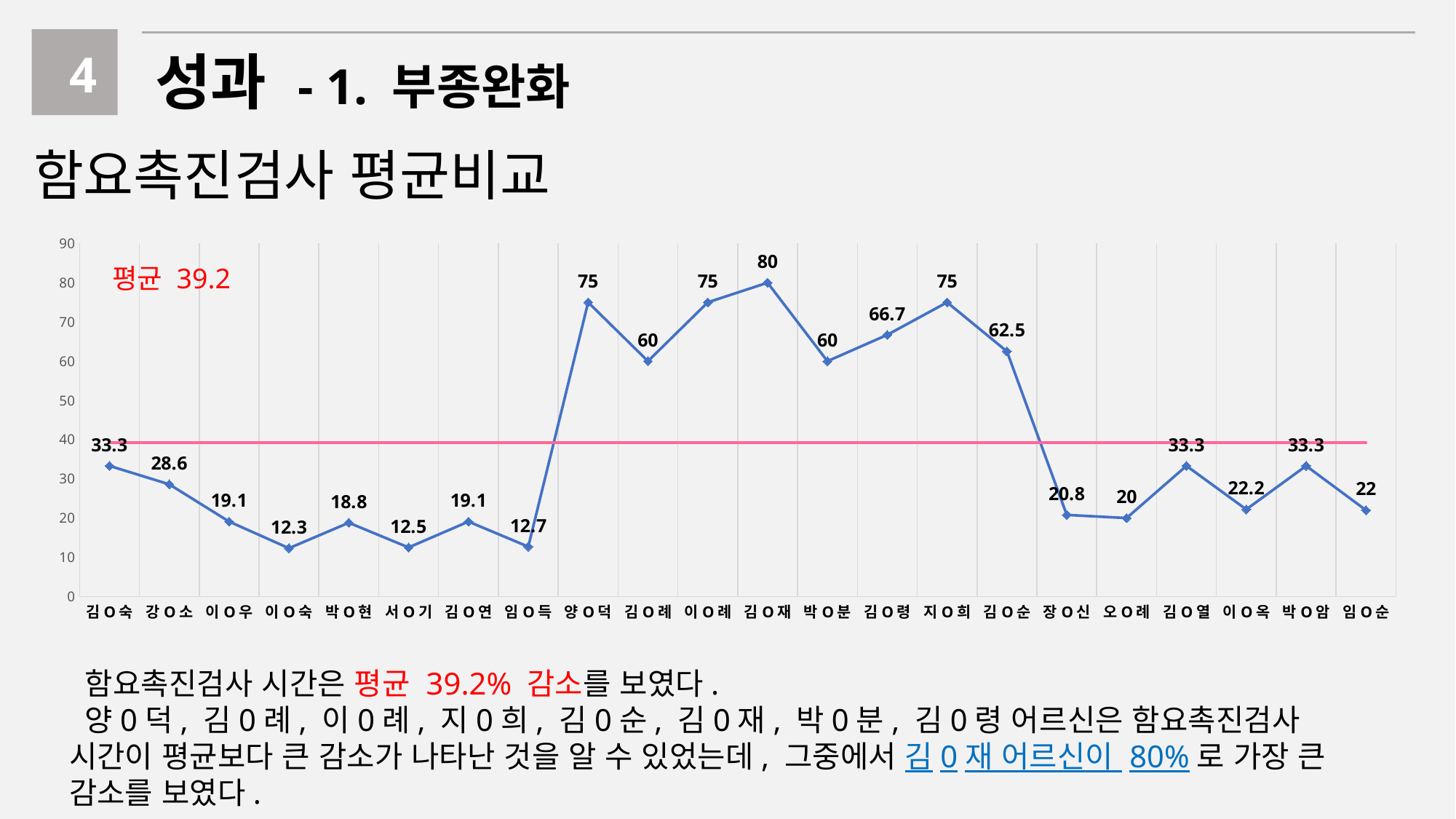
Which is larger, the value for 강O소 or the value for 장O신? 강O소 What is the value for 김O재? 80 What is the value for 김O령? 66.7 Which category has the lowest value? 이O숙 What average value is marked by the red horizontal line on the chart? 39.2 What is the value for 이O숙? 12.3 What is the difference between the values for 김O재 and 김O순? 17.5 Which category has the highest value? 김O재 How many categories are plotted on the x axis? 22 Is the value for 양O덕 greater or less than 70? greater What type of chart is shown on the slide? line chart What is the value for 오O례? 20